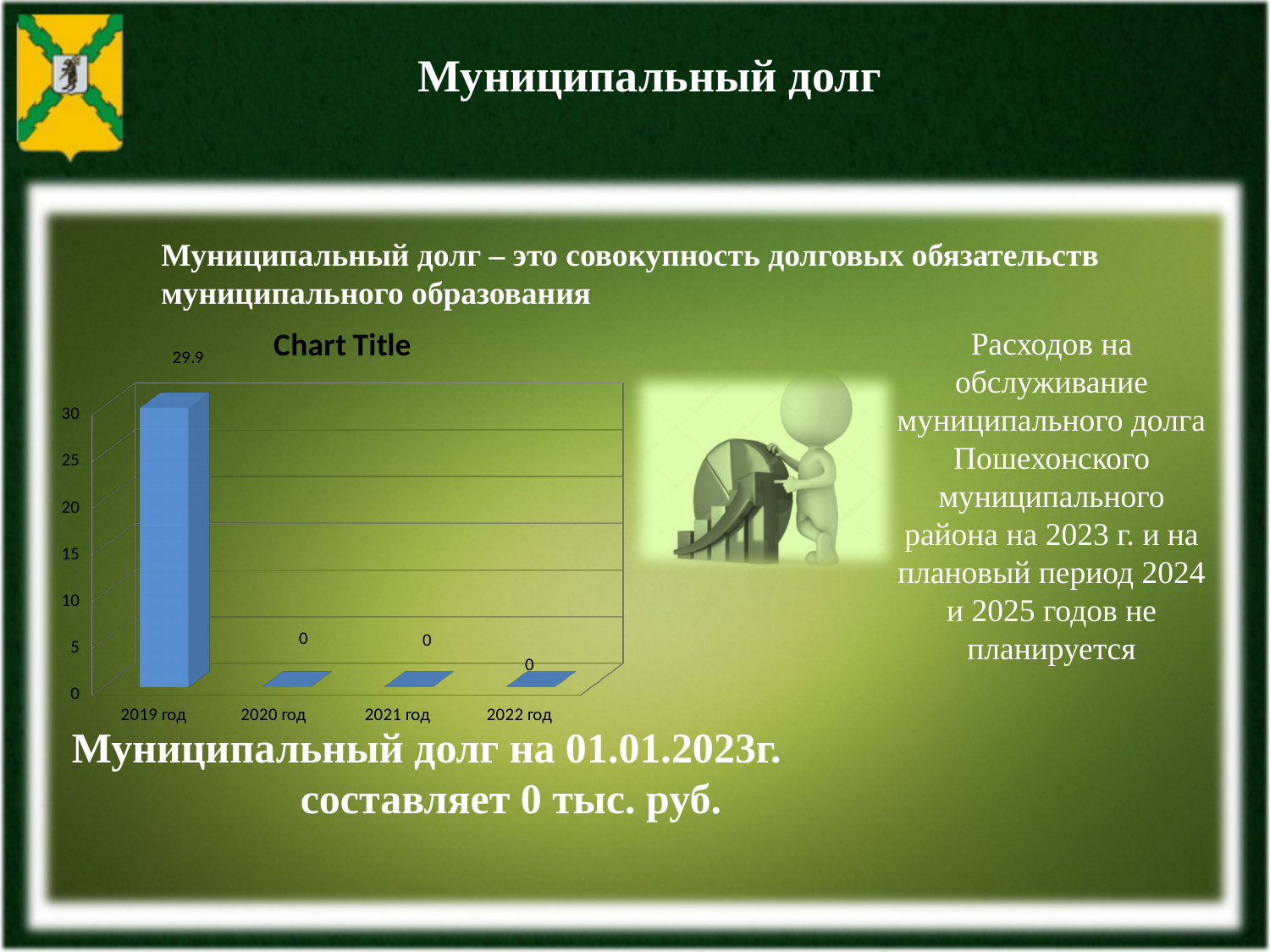
What kind of chart is shown on the slide? bar chart How many categories are shown on the x axis? 4 What is the difference between the values for 2019 год and 2020 год? 29.9 Which category has the highest value? 2019 год Do the values rise or fall from 2019 год to 2020 год? fall What is the value for 2022 год? 0 What is the value for 2020 год? 0 What is the value for 2019 год? 29.9 What is the title of the chart? Chart Title Which is larger, the value for 2019 год or the value for 2022 год? 2019 год What is the value for 2021 год? 0 Is the value for 2019 год greater or less than 25? greater